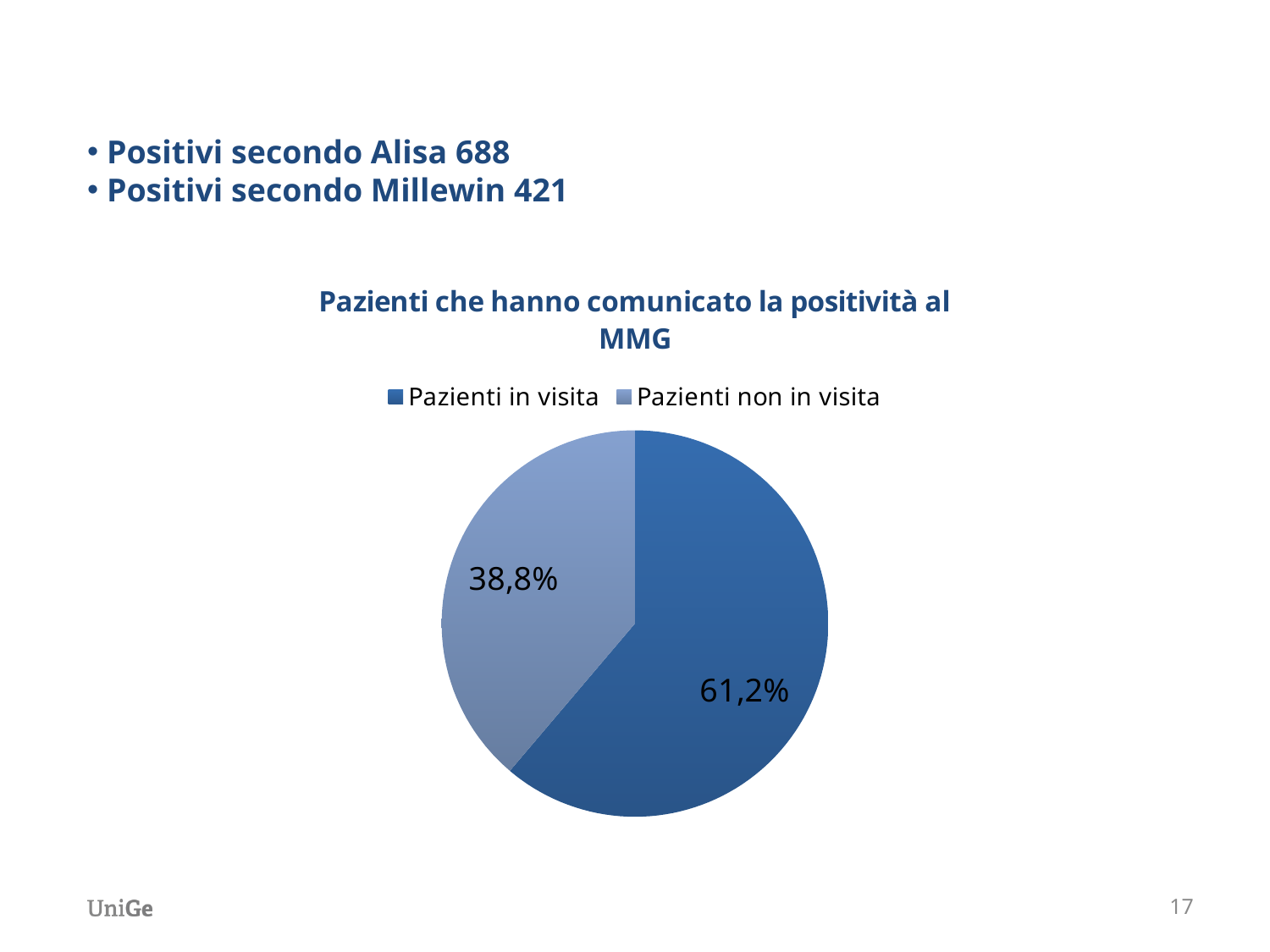
Is the share for 'Pazienti non in visita' greater or less than 50%? less What kind of chart is shown on the slide? pie chart What is the difference in percentage points between 'Pazienti in visita' and 'Pazienti non in visita'? 22,4% Which legend entry is shown in the darker blue colour? Pazienti in visita What share of the pie is 'Pazienti non in visita'? 38,8% How many entries does the chart legend list? 2 Which slice is the largest in the pie chart? Pazienti in visita What is the title of the chart? Pazienti che hanno comunicato la positività al MMG How many slices does the pie chart have? 2 Which slice is the smallest in the pie chart? Pazienti non in visita Which is larger, 'Pazienti in visita' or 'Pazienti non in visita'? Pazienti in visita What share of the pie is 'Pazienti in visita'? 61,2%